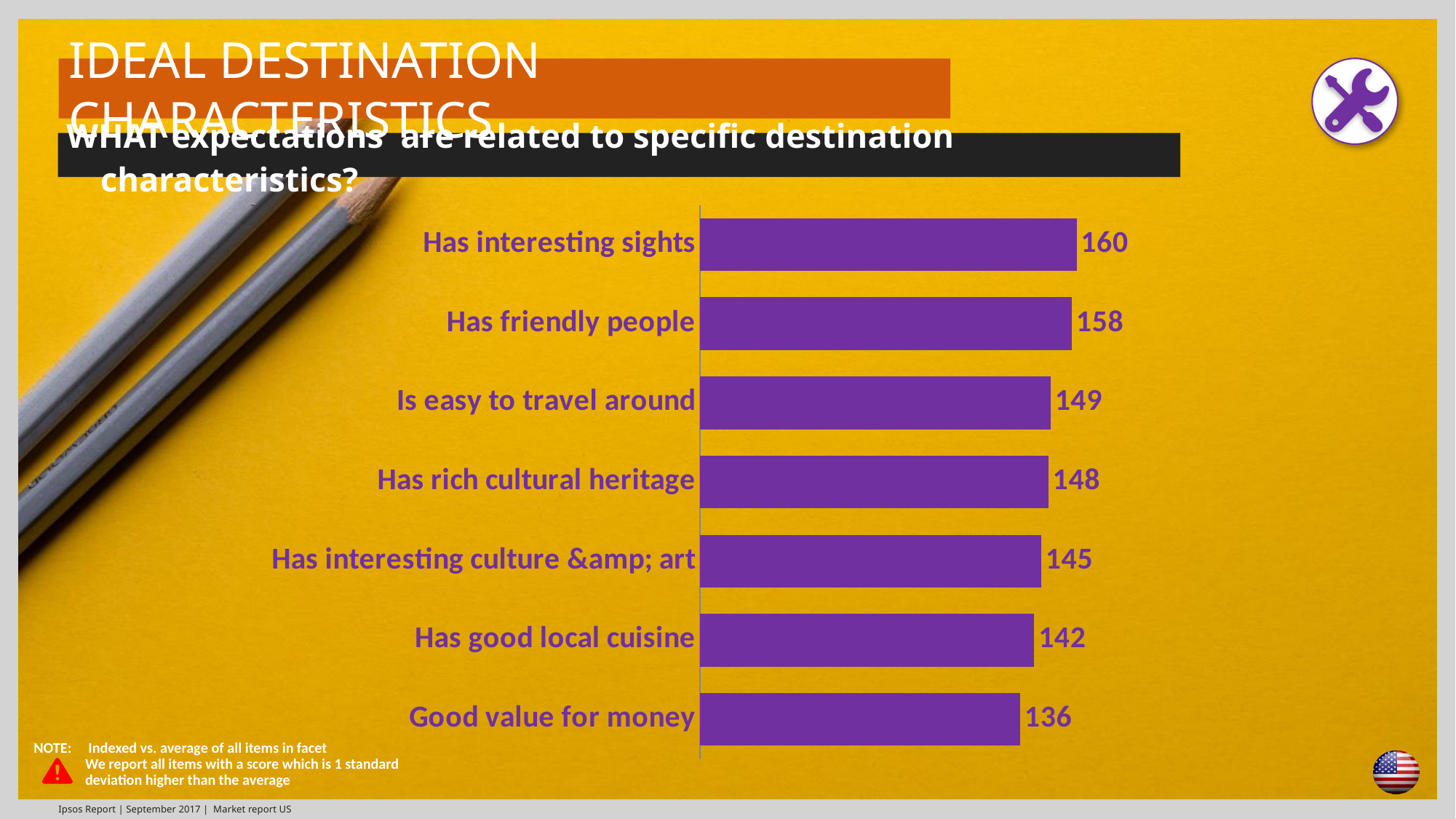
What kind of chart is shown on the slide? Bar chart Which category has the lowest value? Good value for money What is the difference between the values for "Has interesting sights" and "Good value for money"? 24 What colour are the bars in the chart? Purple What is the value for "Has good local cuisine"? 142 Which category has the highest value? Has interesting sights Which is larger, the value for "Has rich cultural heritage" or the value for "Has good local cuisine"? Has rich cultural heritage What is the value for "Is easy to travel around"? 149 What is the value for "Has interesting culture & art"? 145 What is the value for "Has interesting sights"? 160 What is the difference between the values for "Has friendly people" and "Has good local cuisine"? 16 How many categories are shown in the bar chart? 7